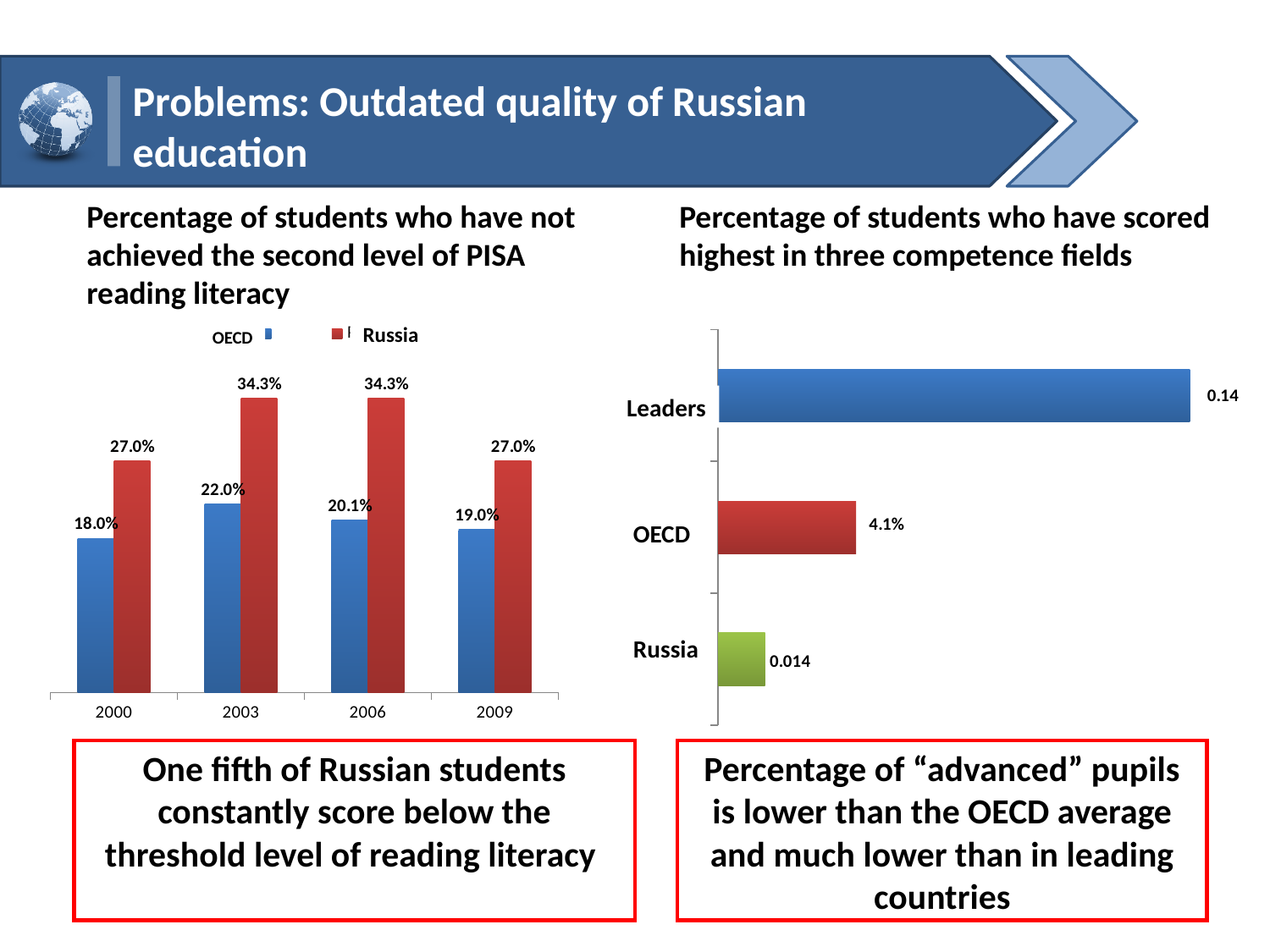
In the right chart (students who have scored highest in three competence fields), what is the value for OECD? 4.1% In the left chart (PISA reading literacy), what is the value for OECD in 2006? 20.1% In the right chart (students who have scored highest in three competence fields), what is the value for Russia? 0.014 What kind of chart is the right chart (percentage of students who have scored highest in three competence fields)? Bar chart In the left chart (PISA reading literacy), which is larger in 2000: the OECD value or the Russia value? Russia In the left chart (PISA reading literacy), how many series does the legend list? 2 In the left chart (PISA reading literacy), what is the value for OECD in 2000? 18.0% In the right chart (students who have scored highest in three competence fields), which category has the longest bar? Leaders In the left chart (PISA reading literacy), in which year is the OECD value highest? 2003 In the left chart (PISA reading literacy), what is the difference between the Russia and OECD values in 2009? 8.0% In the left chart (PISA reading literacy), how many years are shown on the x axis? 4 In the left chart (percentage of students who have not achieved the second level of PISA reading literacy), what is the value for Russia in 2003? 34.3%